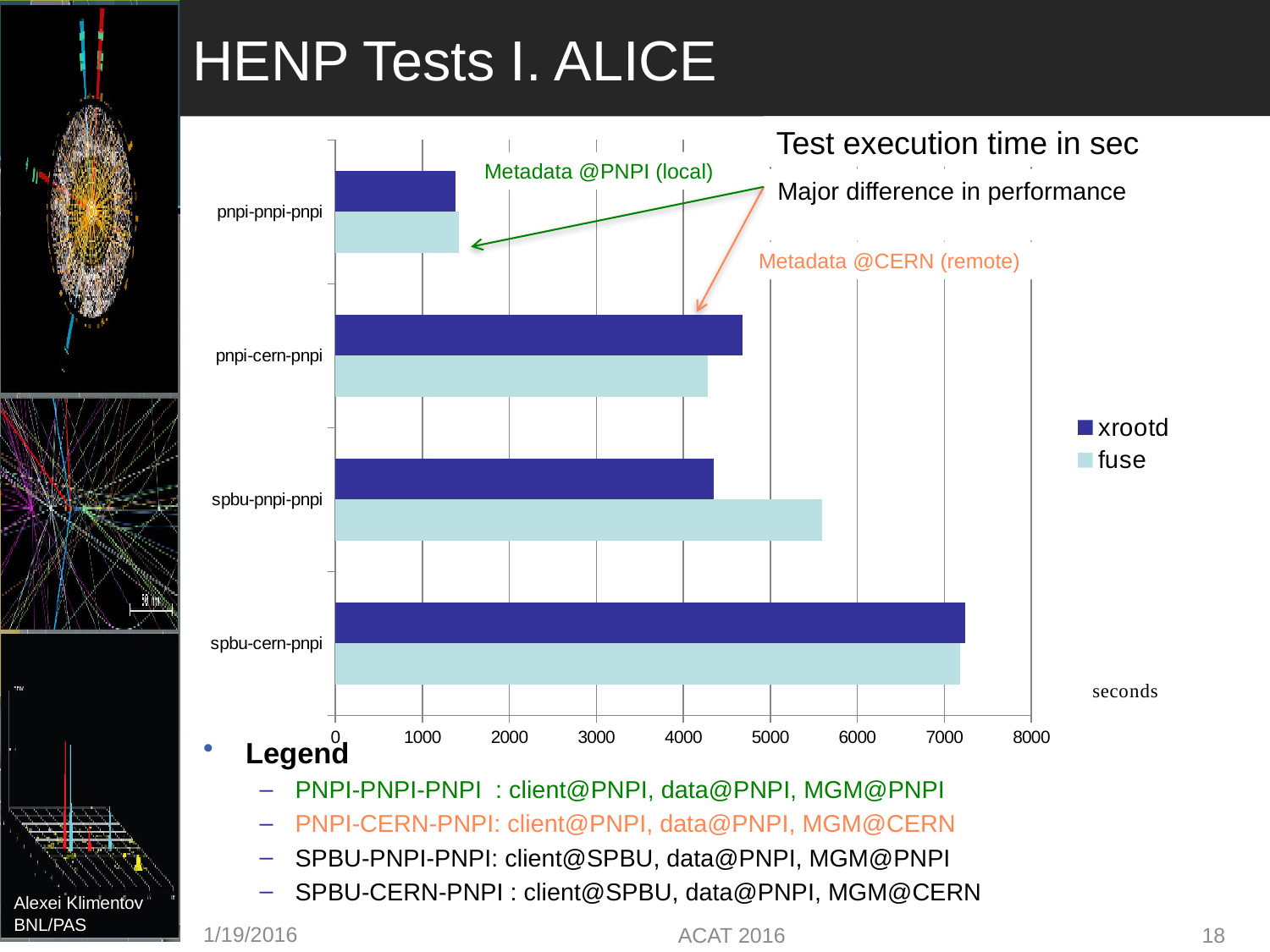
Which configuration has the highest xrootd test execution time? spbu-cern-pnpi What kind of chart is shown on the slide? bar chart How many series does the chart legend list? 2 What unit is the x axis of the chart measured in? seconds Which configuration has the lowest fuse test execution time? pnpi-pnpi-pnpi How many test configurations (categories) are plotted on the chart? 4 What are the two series named in the chart legend? xrootd and fuse Is the xrootd value for pnpi-cern-pnpi greater or less than 4000? greater Is the xrootd value for spbu-cern-pnpi greater or less than 7000? greater Is the fuse value for spbu-pnpi-pnpi greater or less than 5000? greater For spbu-pnpi-pnpi, which is larger: the xrootd time or the fuse time? fuse